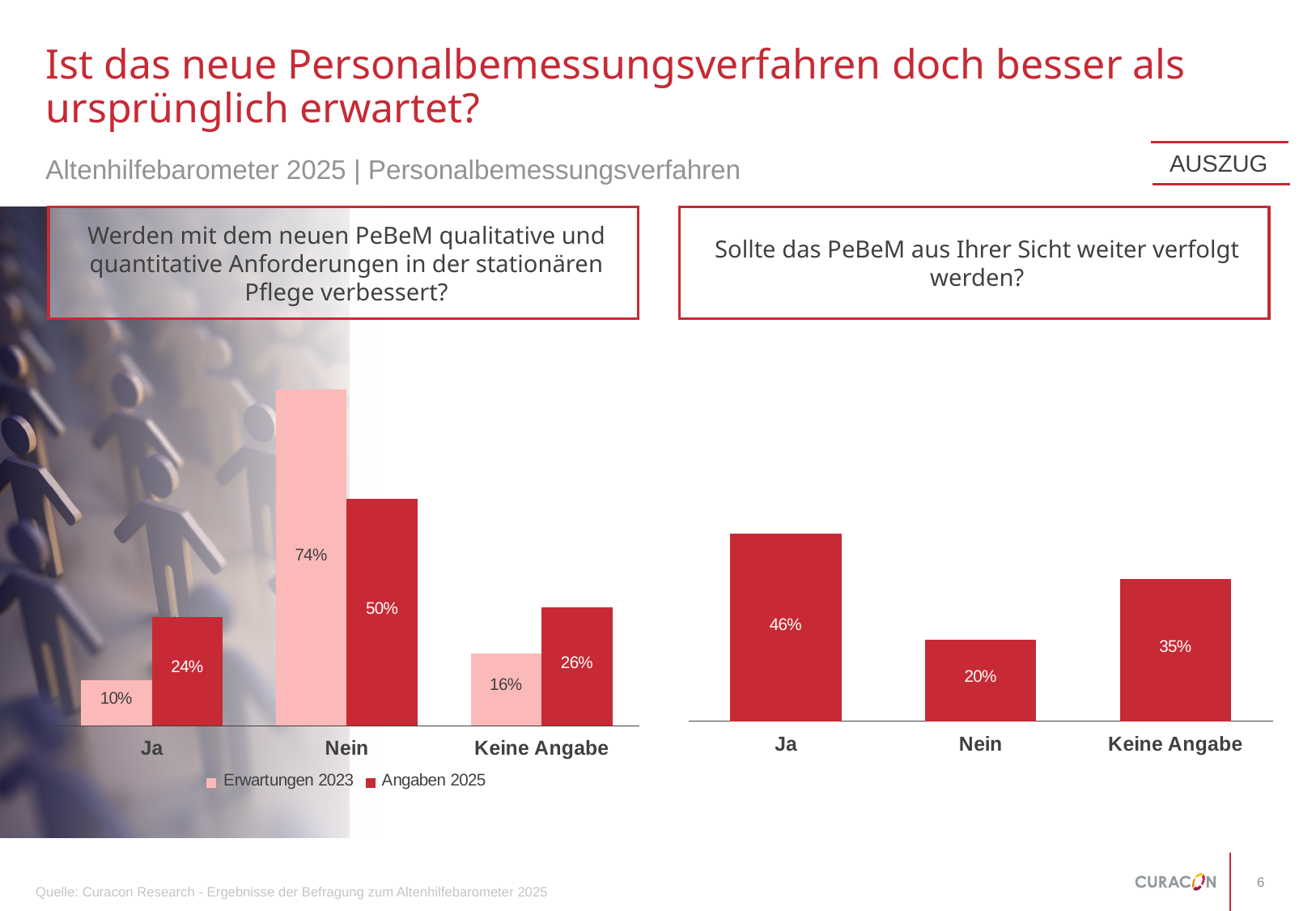
In the right chart, which category has the lowest value? Nein In the right chart ("Sollte das PeBeM aus Ihrer Sicht weiter verfolgt werden?"), what is the value for Ja? 46% In the left chart ("Werden mit dem neuen PeBeM qualitative und quantitative Anforderungen in der stationären Pflege verbessert?"), what is the value for Nein in the Erwartungen 2023 series? 74% What kind of chart is the right chart? Bar chart In the right chart, what is the value for Keine Angabe? 35% In the left chart, what is the value for Ja in the Angaben 2025 series? 24% In the left chart, which is larger for Ja: Erwartungen 2023 or Angaben 2025? Angaben 2025 In the left chart, what is the difference between the Erwartungen 2023 and Angaben 2025 values for Nein? 24% In the left chart, what is the value for Keine Angabe in the Erwartungen 2023 series? 16% In the left chart, which category has the highest value in the Angaben 2025 series? Nein In the right chart, what is the difference between the values for Ja and Nein? 26% How many series does the legend of the left chart list? 2